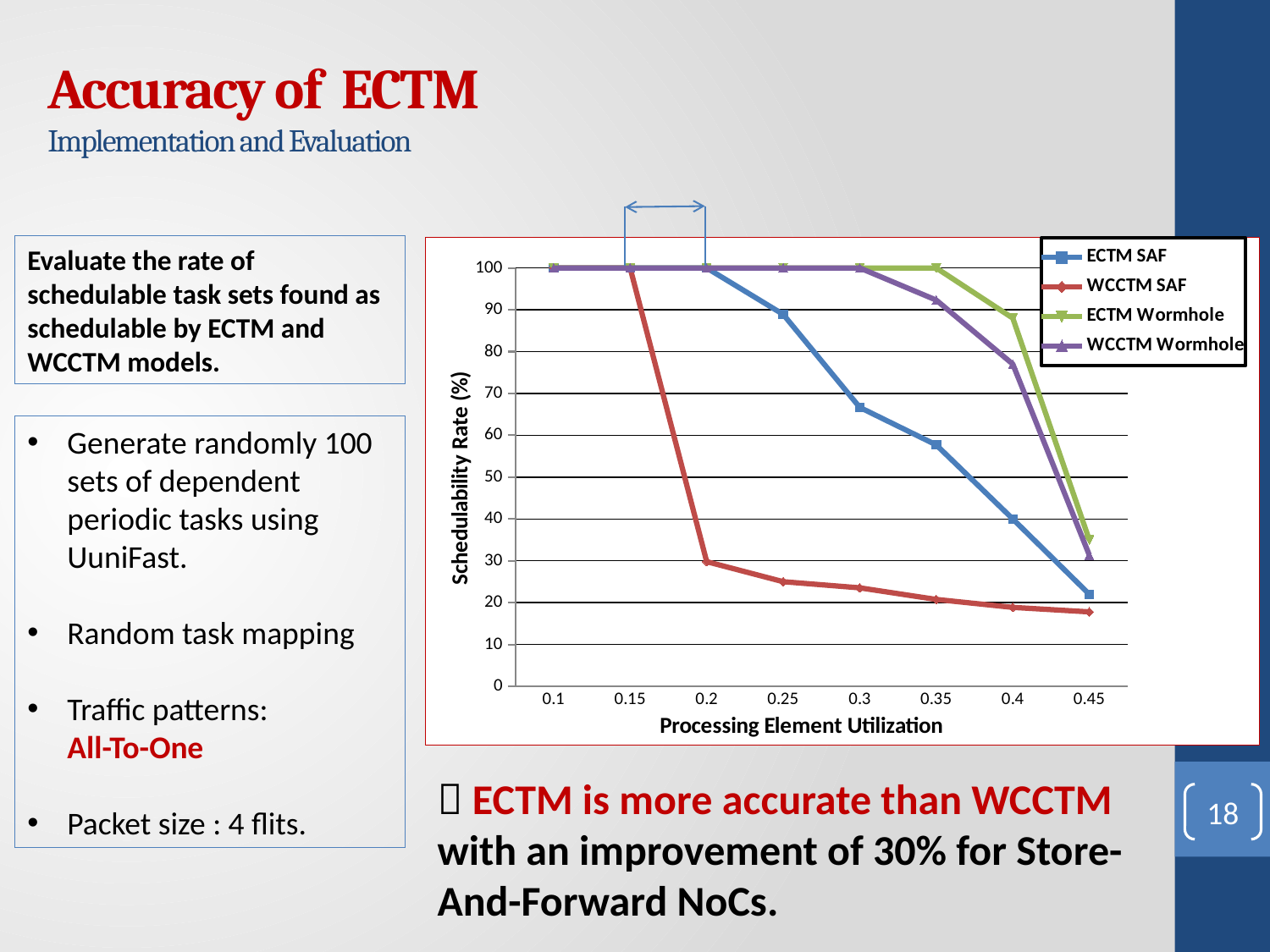
What is the title of the chart's x axis? Processing Element Utilization Does the WCCTM SAF series rise or fall as Processing Element Utilization increases? fall How many series does the chart's legend list? 4 At a Processing Element Utilization of 0.35, which is larger: ECTM Wormhole or WCCTM SAF? ECTM Wormhole What kind of chart is shown on the slide? line chart What is the Schedulability Rate for ECTM Wormhole at a Processing Element Utilization of 0.3? 100 Is the value for WCCTM SAF at 0.2 greater or less than 50? less How many Processing Element Utilization values are plotted along the x axis? 8 Which series has the lowest Schedulability Rate at a Processing Element Utilization of 0.45? WCCTM SAF Which series has the highest Schedulability Rate at a Processing Element Utilization of 0.4? ECTM Wormhole What is the Schedulability Rate for WCCTM SAF at a Processing Element Utilization of 0.15? 100 Is the value for ECTM SAF at 0.25 greater or less than 80? greater